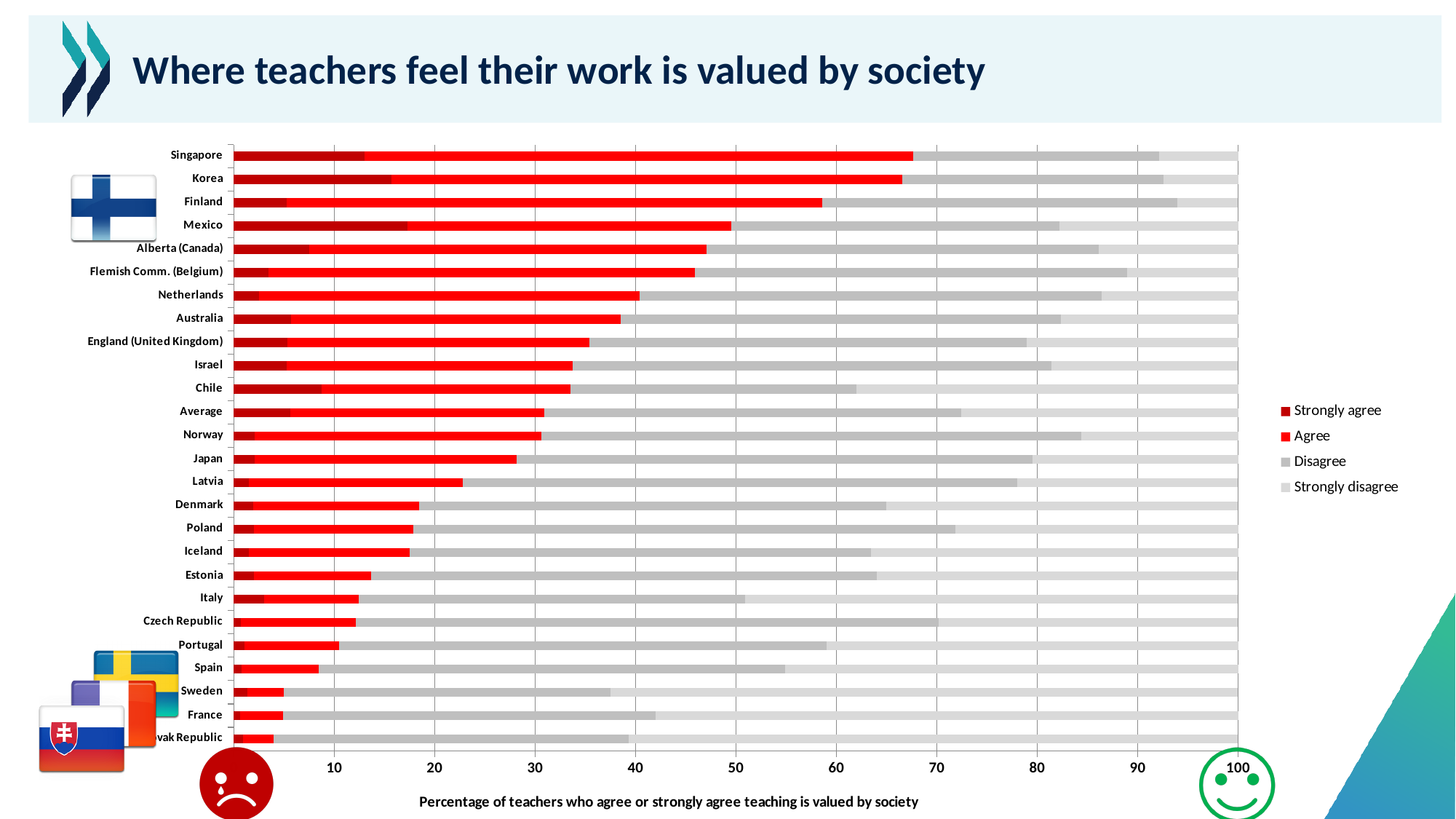
Is the combined agree/strongly agree value for Spain greater or less than 10? less How many series does the legend list? 4 Is the combined agree/strongly agree value for Finland greater or less than 60? less What are the four series listed in the legend? Strongly agree, Agree, Disagree, Strongly disagree Which has a larger Strongly agree share, Mexico or Finland? Mexico Is the combined agree/strongly agree value for Singapore greater or less than 60? greater Which country has the highest combined share of teachers who agree or strongly agree that teaching is valued by society? Singapore Which has a larger combined agree/strongly agree share, Finland or Mexico? Finland What is the title of the slide? Where teachers feel their work is valued by society What kind of chart is shown on the slide? Stacked horizontal bar chart